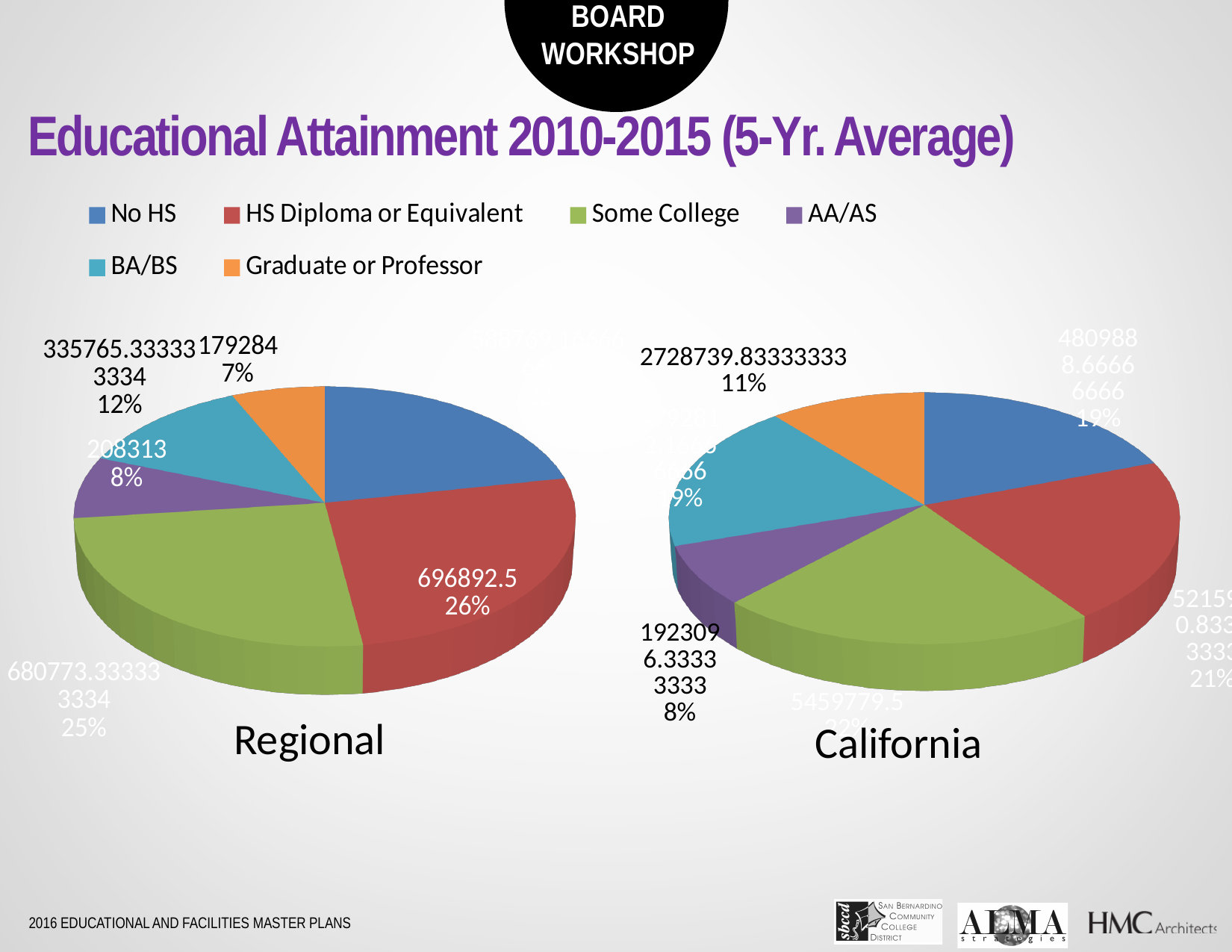
In the Regional pie chart, what is the value for AA/AS? 208313 In the Regional pie chart, what percentage share does BA/BS have? 12% In the Regional pie chart, which is larger: HS Diploma or Equivalent or Graduate or Professor? HS Diploma or Equivalent Which colour represents Some College in the legend? Green In the California pie chart, what percentage share does AA/AS have? 8% How many categories does the legend list? 6 In the Regional pie chart, what is the difference in percentage points between HS Diploma or Equivalent (26%) and Graduate or Professor (7%)? 19 In the Regional pie chart, what percentage share does HS Diploma or Equivalent have? 26% In the Regional pie chart, what is the value for Graduate or Professor? 179284 What type of charts are shown on the slide? Pie charts In the Regional pie chart, what is the value for HS Diploma or Equivalent? 696892.5